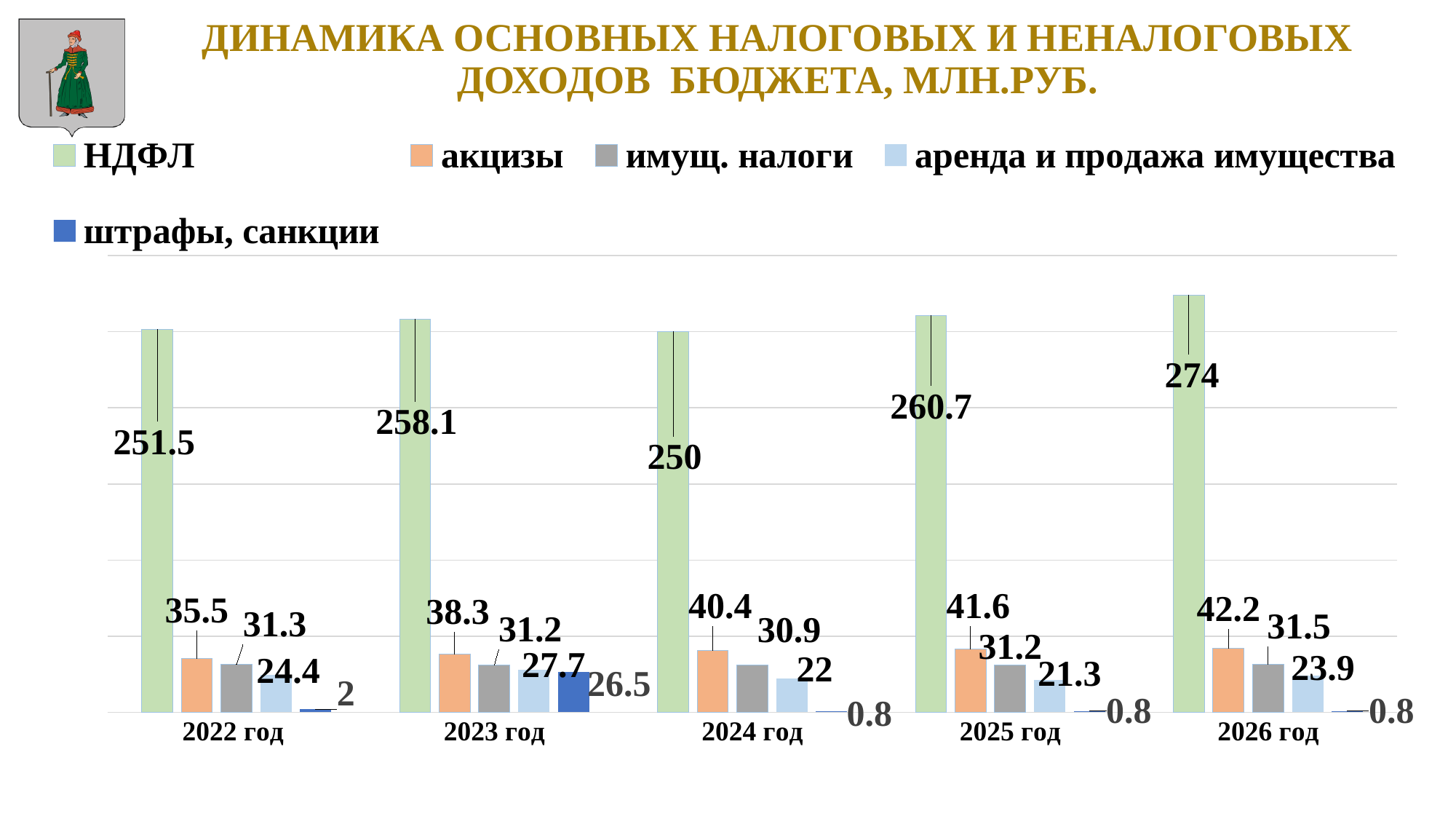
What kind of chart is shown on the slide? bar chart How many years are shown on the x axis? 5 What is the value of штрафы, санкции for 2023 год? 26.5 What is the value of аренда и продажа имущества for 2024 год? 22 Do the values for акцизы rise or fall from 2022 год to 2026 год? rise What is the difference between НДФЛ in 2026 год and 2022 год? 22.5 What is the value of акцизы for 2023 год? 38.3 How many series does the legend list? 5 Which is larger: акцизы in 2025 год or акцизы in 2024 год? акцизы in 2025 год In which year is НДФЛ the highest? 2026 год What is the value of НДФЛ for 2026 год? 274 In which year is НДФЛ the lowest? 2024 год